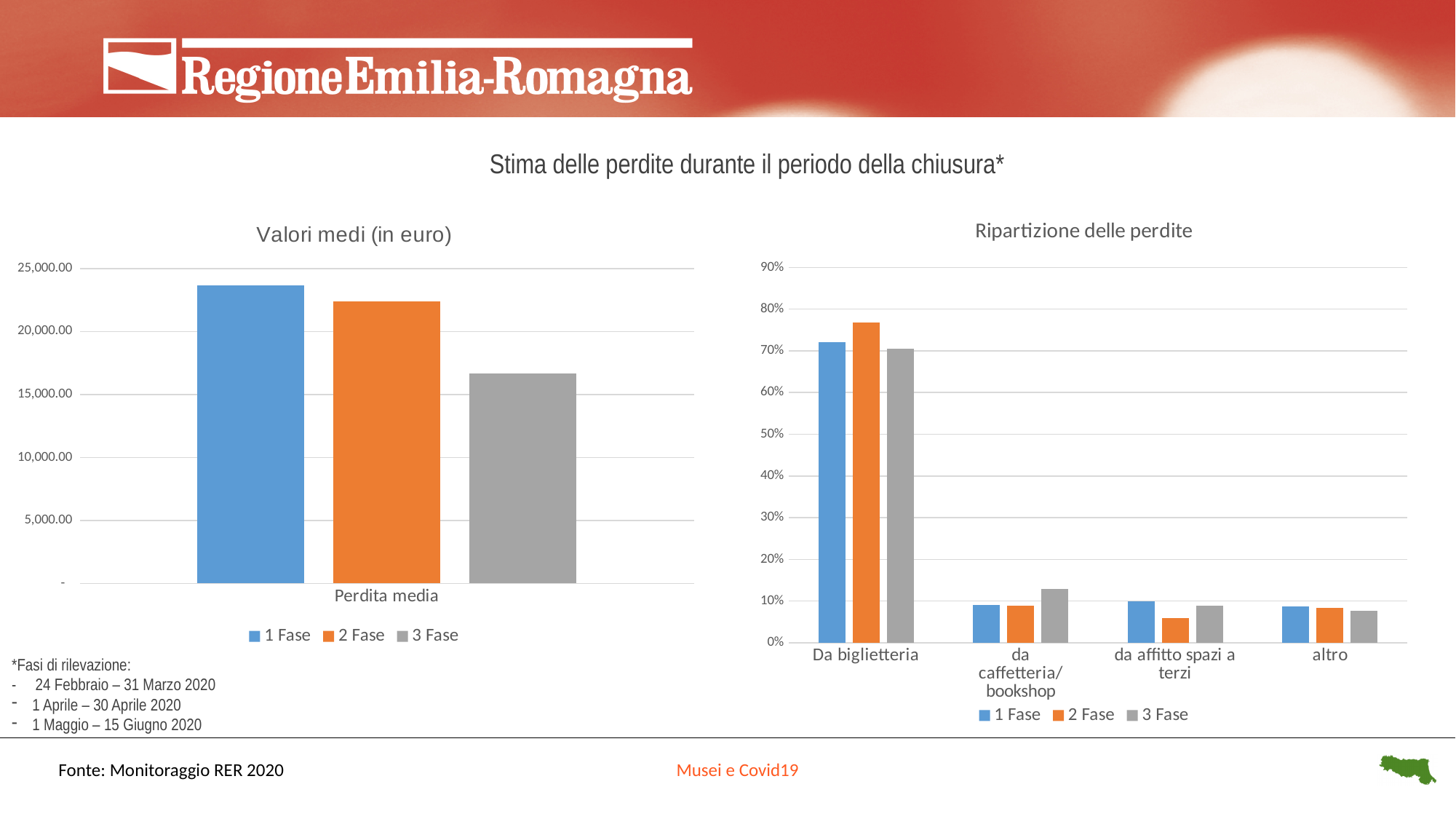
How many categories are shown on the x axis of the 'Ripartizione delle perdite' chart? 4 In the 'Valori medi (in euro)' chart, how many series does the legend list? 3 In the 'Ripartizione delle perdite' chart, which series has the highest value for Da biglietteria? 2 Fase In the 'Valori medi (in euro)' chart, is the value for 3 Fase greater or less than 20,000.00? less In the 'Ripartizione delle perdite' chart, is the value of 3 Fase for da caffetteria/bookshop greater or less than 10%? greater In the 'Valori medi (in euro)' chart, which series has the highest value for Perdita media? 1 Fase In the 'Ripartizione delle perdite' chart, is the value of 3 Fase for Da biglietteria greater or less than 80%? less In the 'Ripartizione delle perdite' chart, which category has the highest value for 1 Fase? Da biglietteria What kind of chart is the 'Ripartizione delle perdite' chart? bar chart In the 'Valori medi (in euro)' chart, which series has the lowest value for Perdita media? 3 Fase